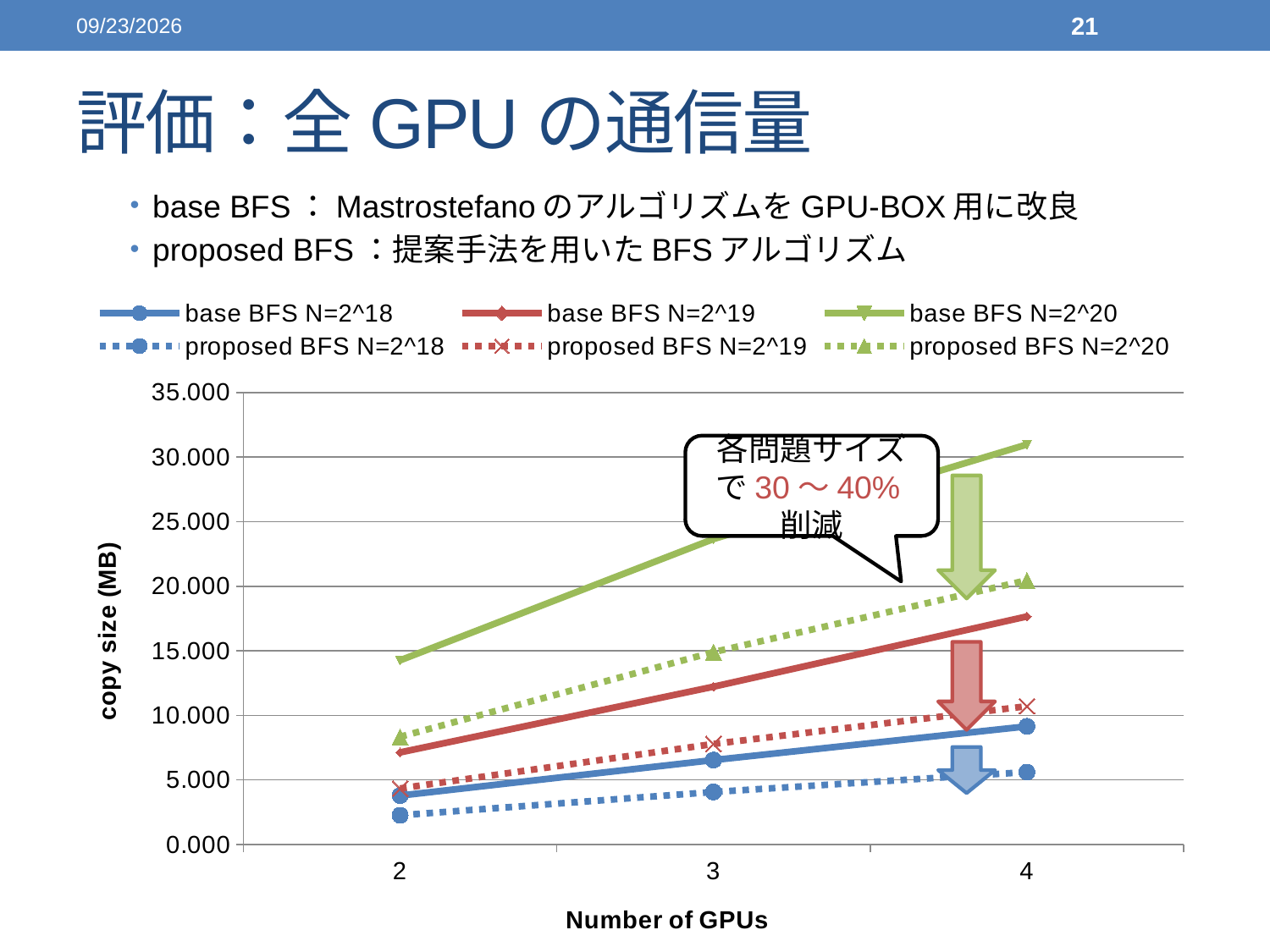
How many values of Number of GPUs are plotted on the x axis? 3 How many series does the legend list? 6 At 3 GPUs, which has the larger copy size: base BFS N=2^19 or proposed BFS N=2^20? proposed BFS N=2^20 Which series has the highest copy size at 4 GPUs? base BFS N=2^20 Which series has the lowest copy size at 4 GPUs? proposed BFS N=2^18 Is the copy size for proposed BFS N=2^20 at 4 GPUs greater or less than 25.000? less What kind of chart is shown on the slide? line chart Is the copy size for base BFS N=2^19 at 2 GPUs greater or less than 10.000? less What is the label of the y axis? copy size (MB) Is the copy size for proposed BFS N=2^18 at 4 GPUs greater or less than 10.000? less Does the copy size for base BFS N=2^20 rise or fall as the number of GPUs increases from 2 to 4? rise